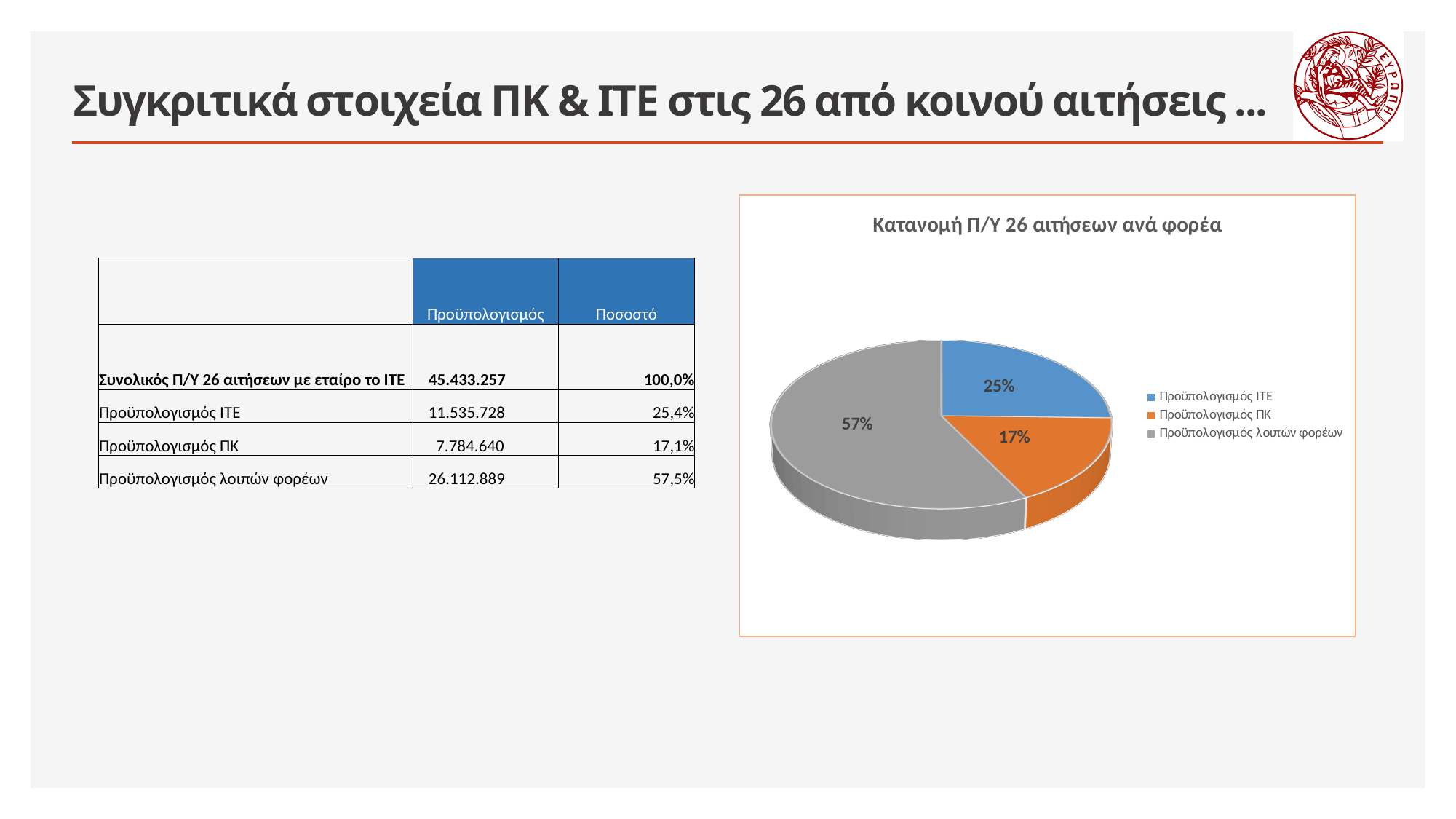
What share of the pie does Προϋπολογισμός λοιπών φορέων have? 57% How many entries does the legend list? 3 What colour is the slice for Προϋπολογισμός ΠΚ? Orange What is the title of the pie chart? Κατανομή Π/Υ 26 αιτήσεων ανά φορέα Which category has the largest slice of the pie? Προϋπολογισμός λοιπών φορέων How many slices does the pie chart have? 3 What share of the pie does Προϋπολογισμός ΠΚ have? 17% Which category has the smallest slice of the pie? Προϋπολογισμός ΠΚ What share of the pie does Προϋπολογισμός ΙΤΕ have? 25% Which is larger, the slice for Προϋπολογισμός ΙΤΕ or the slice for Προϋπολογισμός ΠΚ? Προϋπολογισμός ΙΤΕ What is the difference in percentage points between the Προϋπολογισμός λοιπών φορέων slice and the Προϋπολογισμός ΙΤΕ slice? 32% What kind of chart is shown on the slide? Pie chart